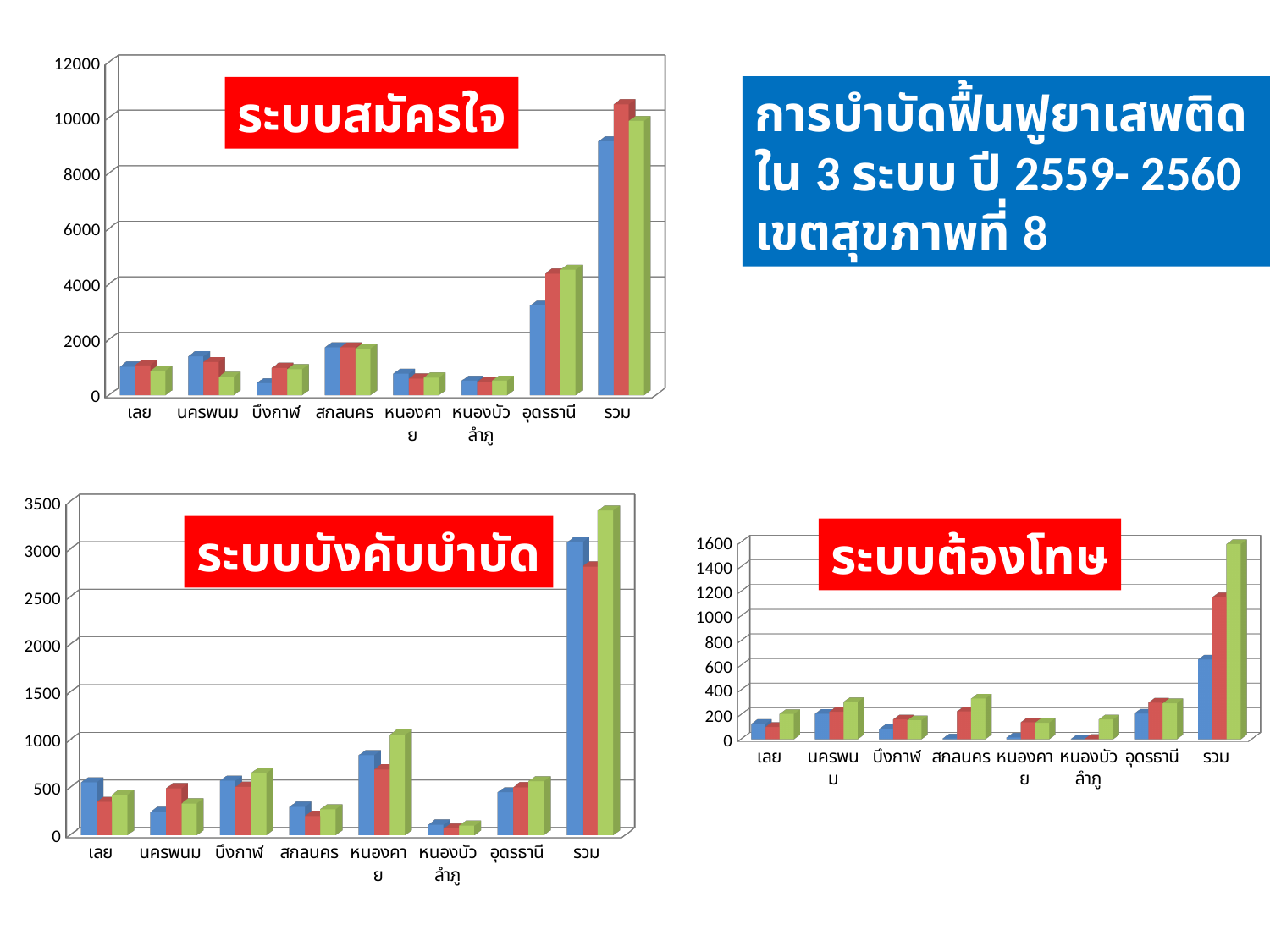
What kind of chart is the ระบบสมัครใจ chart? bar chart In the ระบบบังคับบำบัด chart, is the green bar for รวม greater or less than 3000? greater How many categories are shown on the x axis of the ระบบสมัครใจ chart? 8 In the ระบบต้องโทษ chart, is the blue bar for รวม greater or less than 800? less In the ระบบสมัครใจ chart, which category has taller bars, อุดรธานี or สกลนคร? อุดรธานี In the ระบบสมัครใจ chart, is the blue bar for อุดรธานี greater or less than 4000? less In the ระบบสมัครใจ chart, which category has the tallest bars? รวม In the ระบบบังคับบำบัด chart, which category has the shortest bars? หนองบัวลำภู How many charts are shown on the slide? 3 In the ระบบบังคับบำบัด chart, which category has the tallest bars? รวม